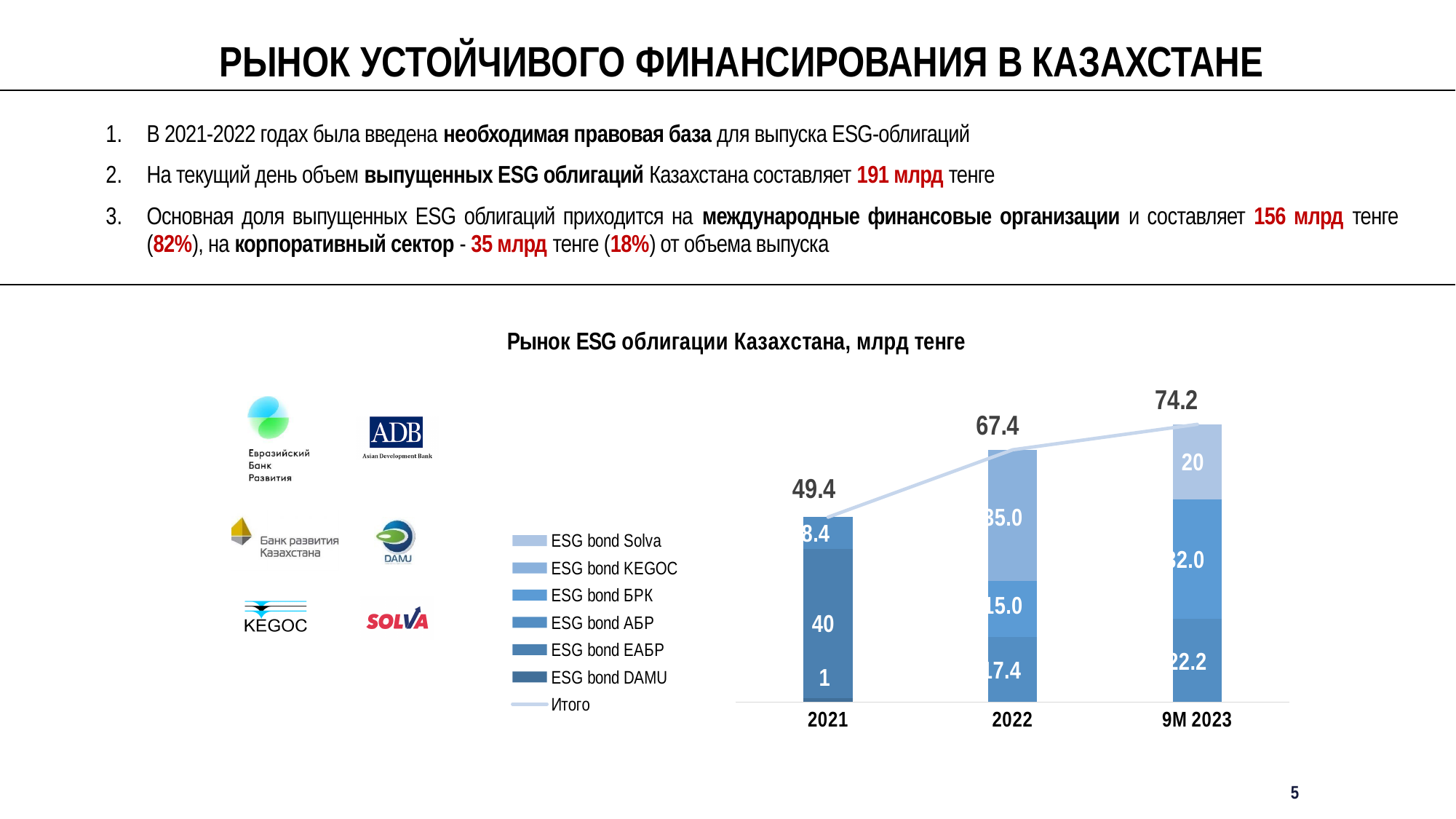
What is the total value shown above the 9M 2023 bar? 74.2 Which period has the lowest total value? 2021 How many periods are shown on the x axis? 3 How many entries does the legend list? 7 Which is larger, the total for 2022 or the total for 9M 2023? 9M 2023 Which period has the highest total value? 9M 2023 What kind of chart is this? stacked bar chart with a line (combination bar and line chart) What is the total value shown above the 2021 bar? 49.4 Do the total values rise or fall from 2021 to 9M 2023? rise What is the total value shown above the 2022 bar? 67.4 By how much did the total increase from 2021 to 2022? 18.0 By how much did the total increase from 2022 to 9M 2023? 6.8